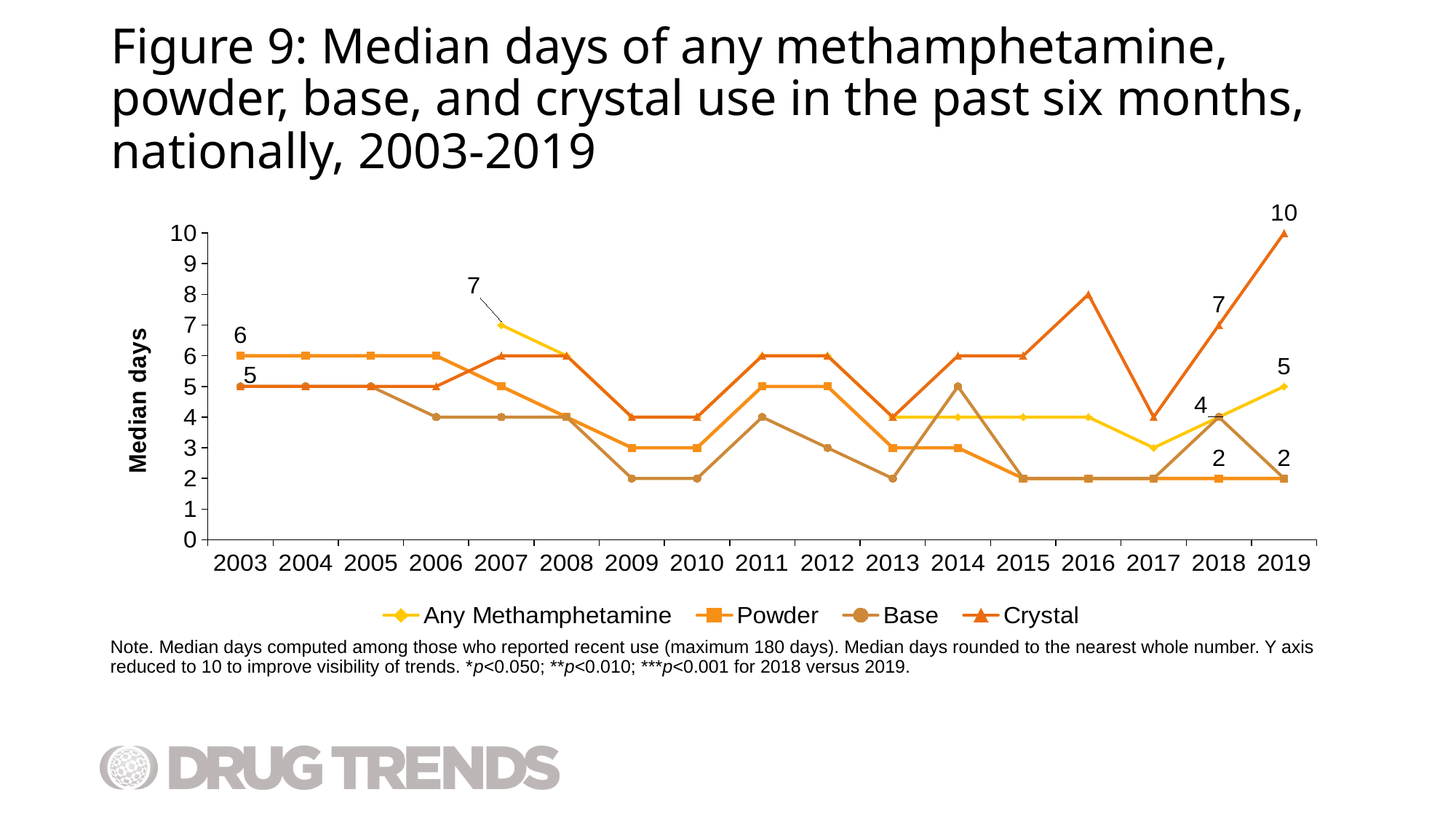
How many years are shown along the x axis? 17 What is the median days value for Crystal in 2019? 10 What is the median days value for Base in 2018? 4 What is the median days value for Any Methamphetamine in 2019? 5 What is the median days value for Crystal in 2018? 7 What is the median days value for Powder in 2003? 6 What kind of chart is shown on the slide? line chart How many series does the legend list? 4 Which series has the highest value in 2019? Crystal By how many days did the Crystal value increase from 2018 to 2019? 3 What is the title of the y axis? Median days What is the median days value for Any Methamphetamine in 2007? 7